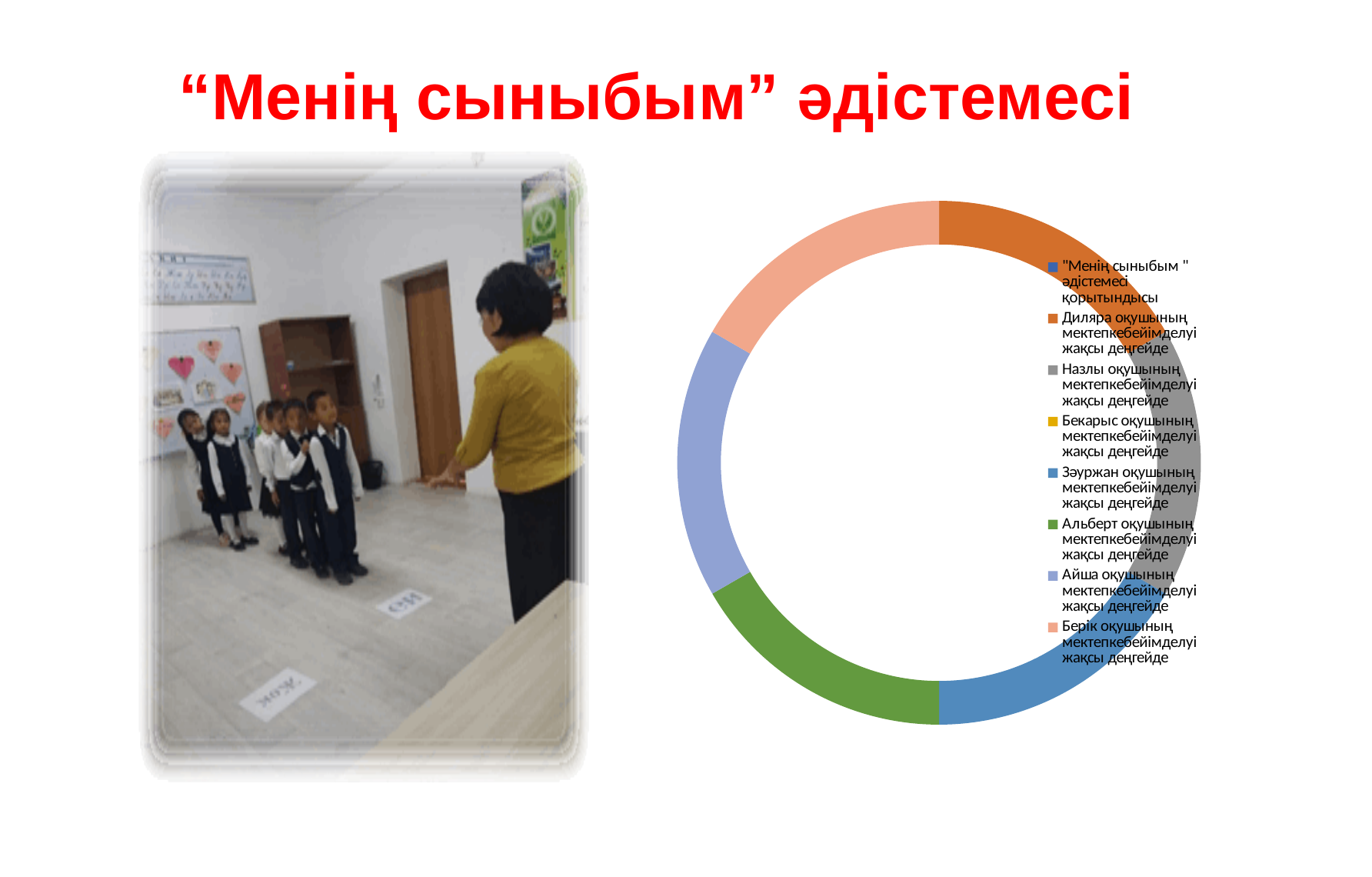
What colour is the slice for Диляра оқушының мектепкебейімделуі жақсы деңгейде? orange Which slice is larger: the one for Назлы or the one for Диляра? Neither; they are the same size How many entries does the chart's legend list? 8 What kind of chart is shown on the slide? doughnut (pie) chart What colour is the slice for Альберт оқушының мектепкебейімделуі жақсы деңгейде? green